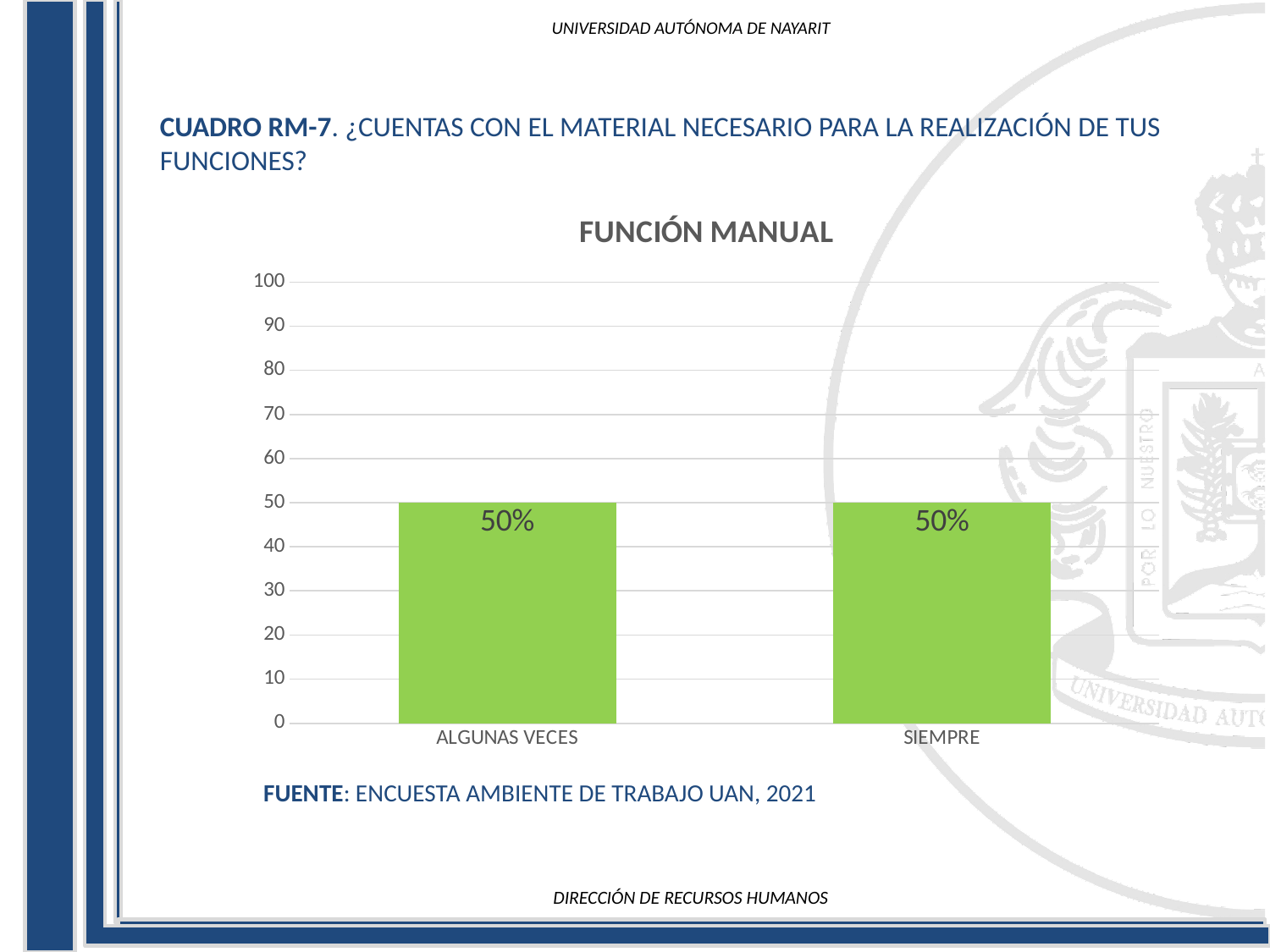
What is the value for SIEMPRE? 50% What kind of chart is shown? bar chart What is the value for ALGUNAS VECES? 50% Is the value for SIEMPRE greater or less than 60? less What is the maximum value shown on the y axis? 100 What is the total of the values for ALGUNAS VECES and SIEMPRE? 100% What is the difference between the values for ALGUNAS VECES and SIEMPRE? 0 What is the title of the chart? FUNCIÓN MANUAL Is the value for ALGUNAS VECES greater or less than 40? greater How many categories are shown on the x axis? 2